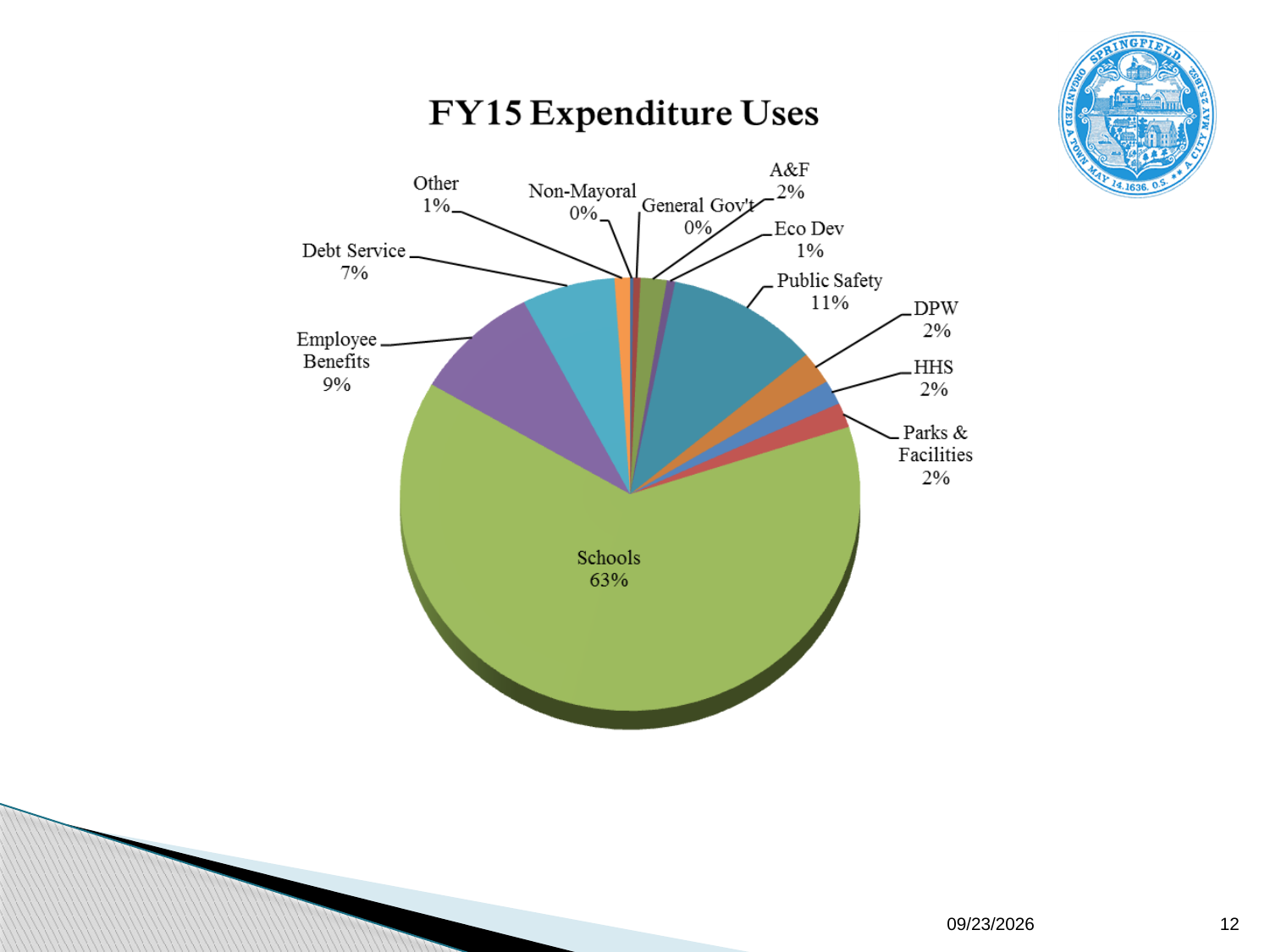
What is the difference in percentage points between Schools and Public Safety? 52 What is the value shown for Employee Benefits? 9% What is the title of the chart? FY15 Expenditure Uses Which is larger, Employee Benefits or Debt Service? Employee Benefits How many categories are labelled on the pie chart? 12 Which category has the largest share of the pie? Schools What percentage is shown for Non-Mayoral? 0% What kind of chart is shown on the slide? Pie chart What is the value shown for Debt Service? 7% What share of FY15 expenditure uses goes to Schools? 63% What percentage of the pie is Public Safety? 11% What is the combined share of Public Safety and Employee Benefits? 20%